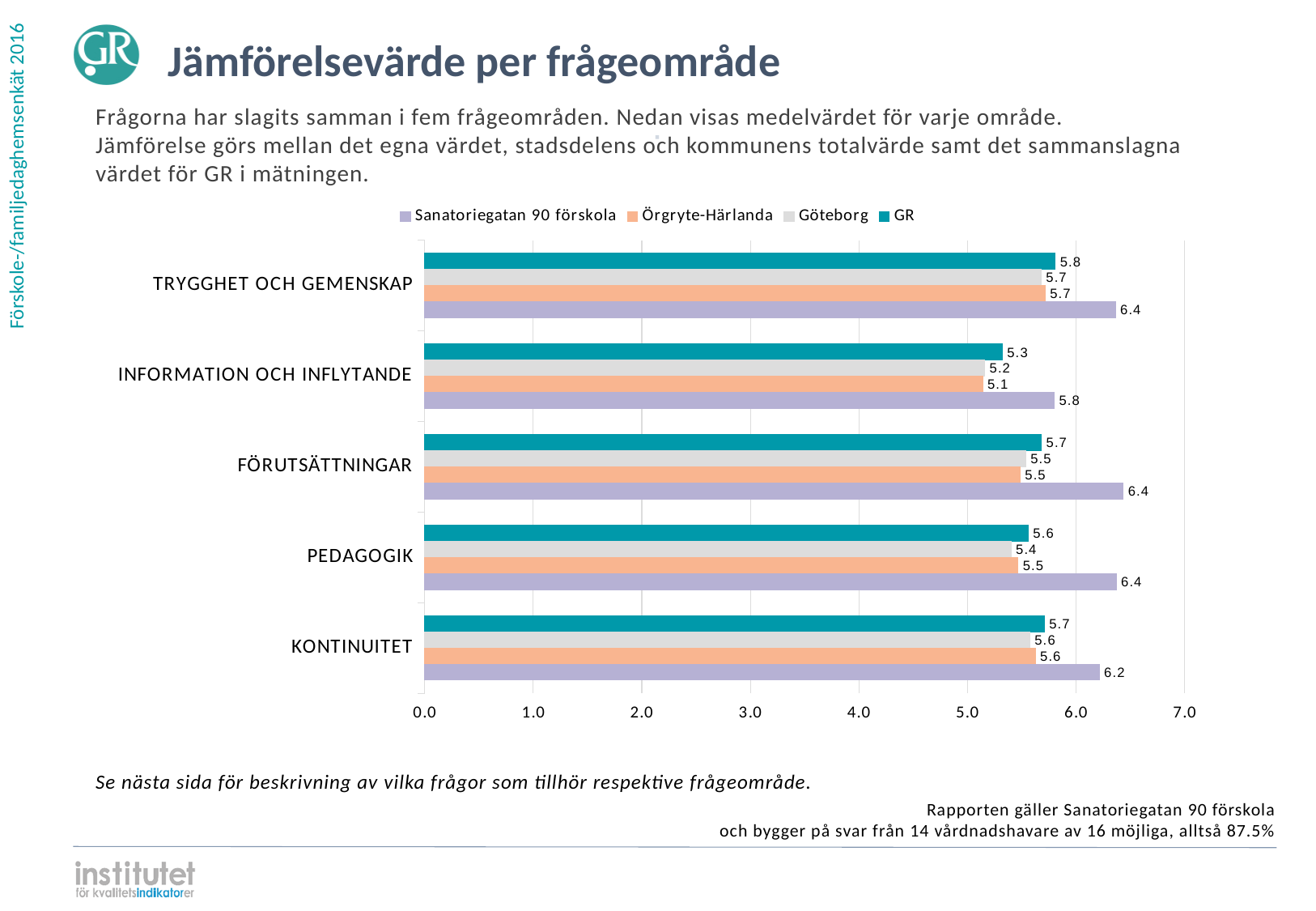
In which category does GR have its highest value? TRYGGHET OCH GEMENSKAP In which category does Sanatoriegatan 90 förskola have its lowest value? INFORMATION OCH INFLYTANDE What is the difference between the Sanatoriegatan 90 förskola value and the GR value in the FÖRUTSÄTTNINGAR category? 0.7 In the PEDAGOGIK category, which is larger: the value for Sanatoriegatan 90 förskola or the value for Göteborg? Sanatoriegatan 90 förskola What kind of chart is shown on the slide? Bar chart Which series is shown in teal in the legend? GR What is the value for Örgryte-Härlanda in the PEDAGOGIK category? 5.5 How many categories are shown on the chart? 5 What is the value for GR in the INFORMATION OCH INFLYTANDE category? 5.3 What is the value for Sanatoriegatan 90 förskola in the TRYGGHET OCH GEMENSKAP category? 6.4 What is the value for Göteborg in the KONTINUITET category? 5.6 How many series does the legend list? 4